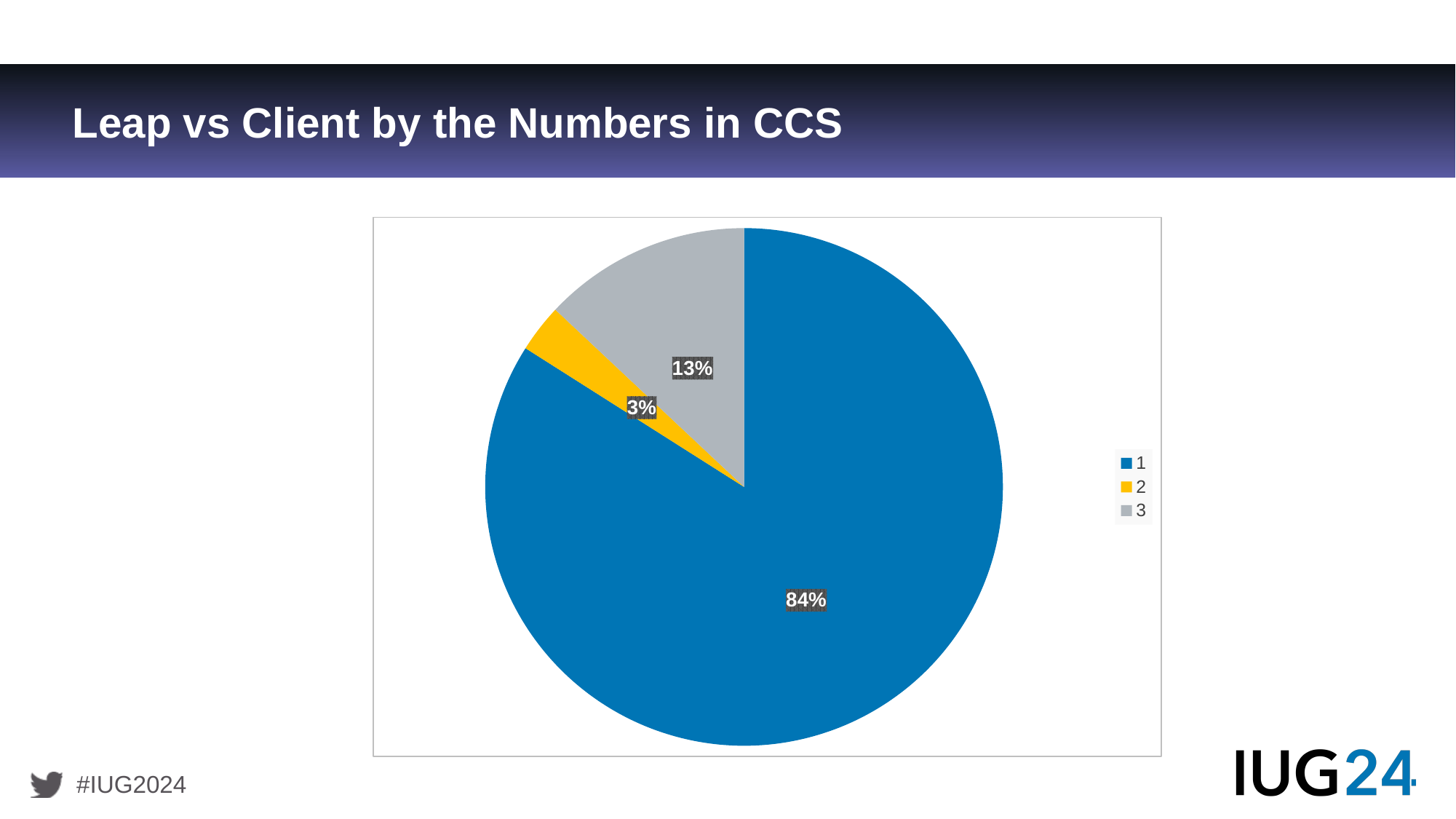
What share of the pie does category 2 have? 3% Which is larger, the slice for category 2 or the slice for category 3? 3 How many entries does the legend list? 3 What share of the pie does category 1 have? 84% What is the difference in percentage points between category 3 and category 2? 10 What kind of chart is shown on the slide? pie chart Which category has the largest slice of the pie? 1 What colour is the slice for category 2? yellow What is the difference in percentage points between category 1 and category 3? 71 How many slices does the pie chart have? 3 Which category has the smallest slice of the pie? 2 What share of the pie does category 3 have? 13%